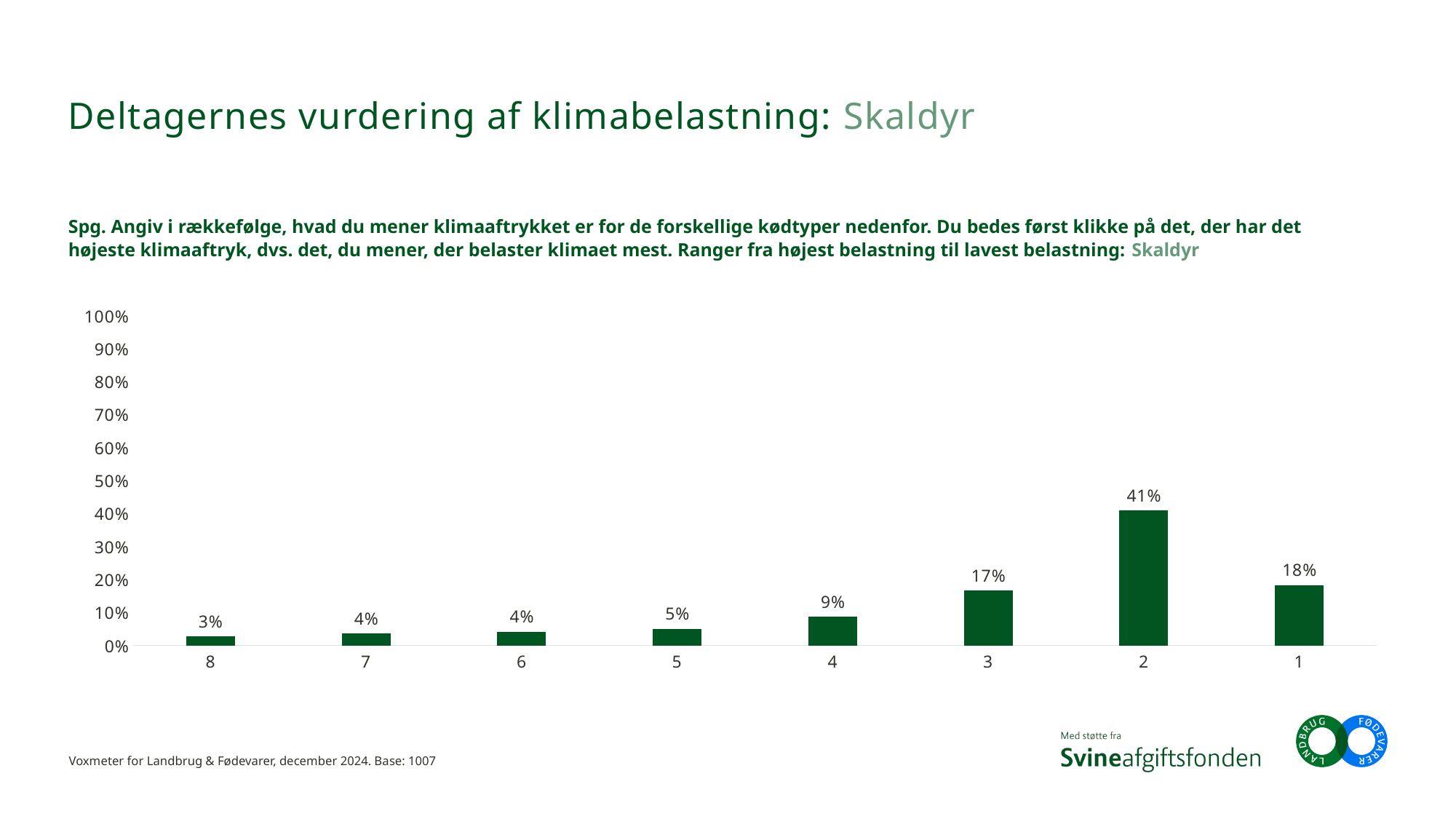
What is the value for category 4? 9% What is the value for category 2? 41% Is the value for category 2 greater or less than 50%? less What is the value for category 1? 18% What kind of chart is shown on the slide? bar chart Which category has the lowest value? 8 Which is larger, the value for category 3 or the value for category 1? 1 How many categories are shown on the x axis? 8 What is the difference between the values for category 2 and category 1? 23% What is the title of the slide? Deltagernes vurdering af klimabelastning: Skaldyr What is the value for category 8? 3% Which category has the highest value? 2